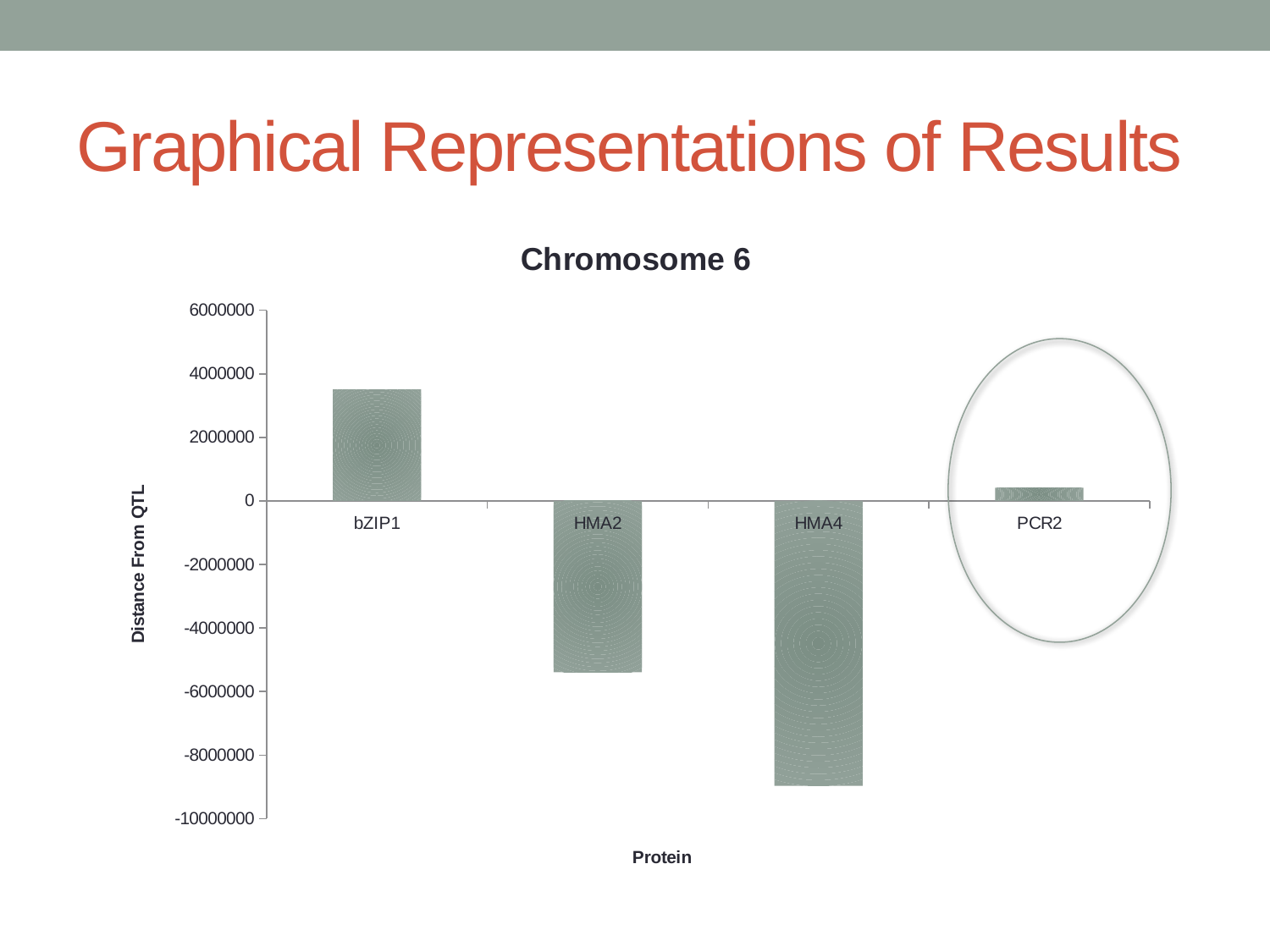
What is the label of the vertical axis of the chart? Distance From QTL Is the value for HMA4 greater or less than -8000000? less Which protein has the lowest value for Distance From QTL? HMA4 Is the value for HMA2 greater or less than -4000000? less Which protein has the highest value for Distance From QTL? bZIP1 Which has the larger value, bZIP1 or PCR2? bZIP1 Is the value for PCR2 greater or less than 2000000? less What is the title of the chart? Chromosome 6 How many proteins are plotted on the x axis of the chart? 4 What kind of chart is shown on the slide? bar chart Which has the larger value, HMA2 or HMA4? HMA2